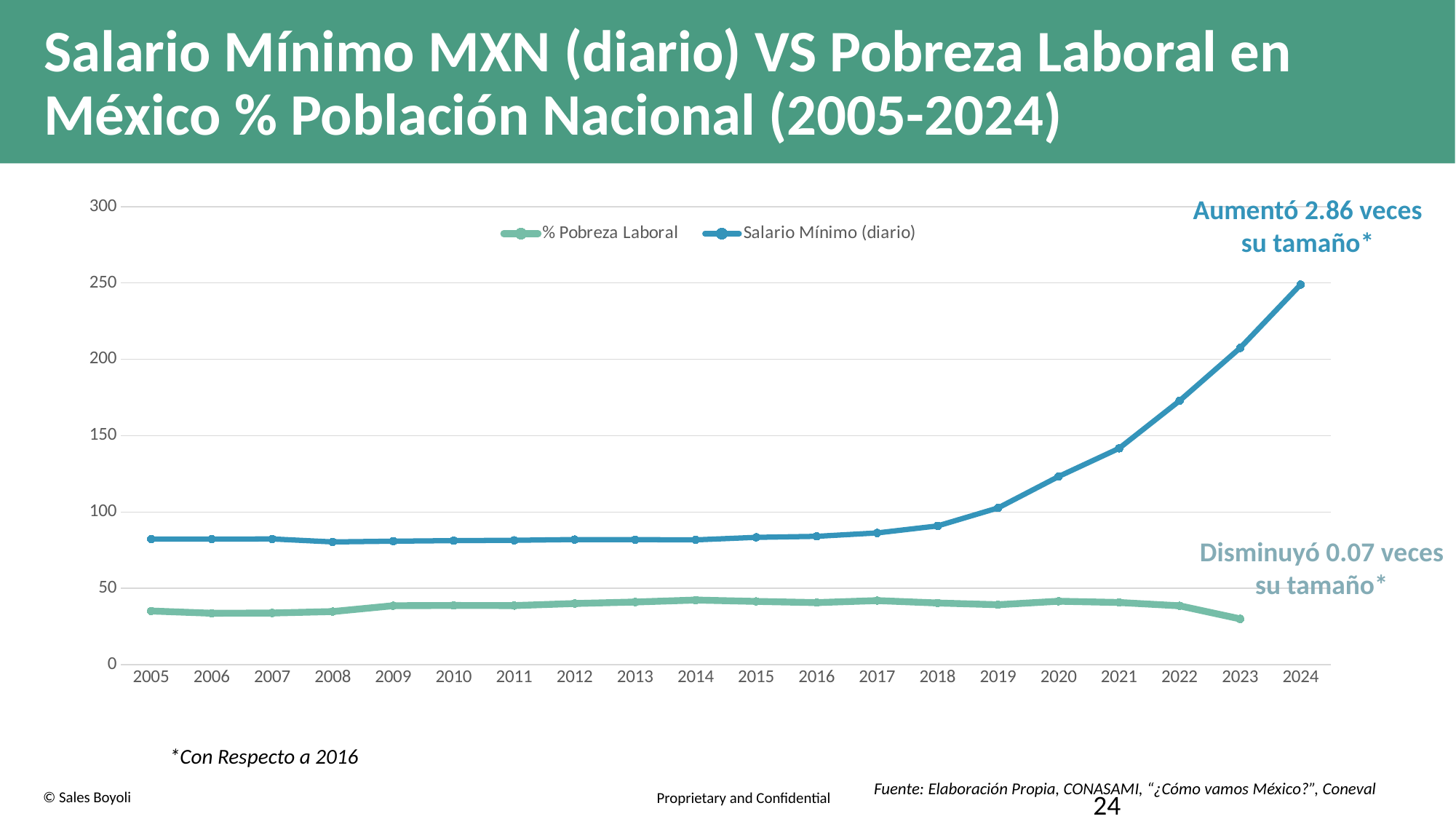
In which year is the Salario Mínimo (diario) highest? 2024 Is the value for Salario Mínimo (diario) in 2005 greater or less than 100? less How many series does the legend list? 2 Which series does the blue line represent? Salario Mínimo (diario) What kind of chart is shown on the slide? Line chart Does the Salario Mínimo (diario) line rise or fall from 2018 to 2024? Rise How many years are shown along the x axis? 20 According to the annotation, by how many times did the Salario Mínimo increase in size? 2.86 veces Is the value for % Pobreza Laboral in 2023 greater or less than 50? less Is the value for Salario Mínimo (diario) in 2024 greater or less than 200? greater In which year is the % Pobreza Laboral lowest? 2023